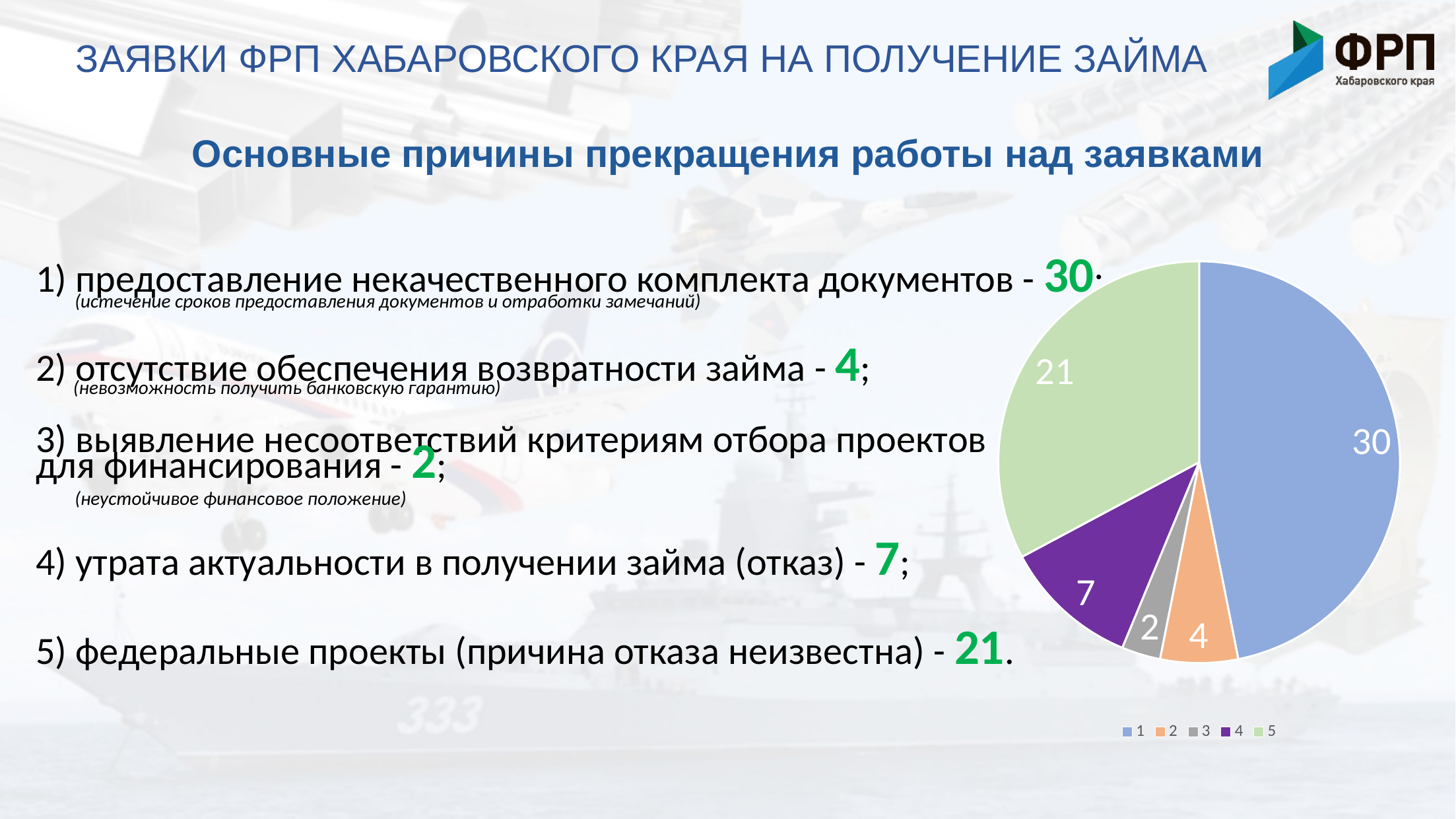
What is the value of slice 2 in the pie chart? 4 Which is larger in the pie chart, slice 4 or slice 2? 4 How many slices does the pie chart have? 5 What is the difference between the values of slice 4 and slice 2 in the pie chart? 3 What is the difference between the values of slice 1 and slice 5 in the pie chart? 9 Which slice of the pie chart has the largest value? 1 What type of chart is shown on the slide? pie chart What is the value of slice 1 in the pie chart? 30 Which slice of the pie chart has the smallest value? 3 What is the value of slice 4 in the pie chart? 7 What colour is slice 1 in the pie chart? blue What is the value of slice 5 in the pie chart? 21